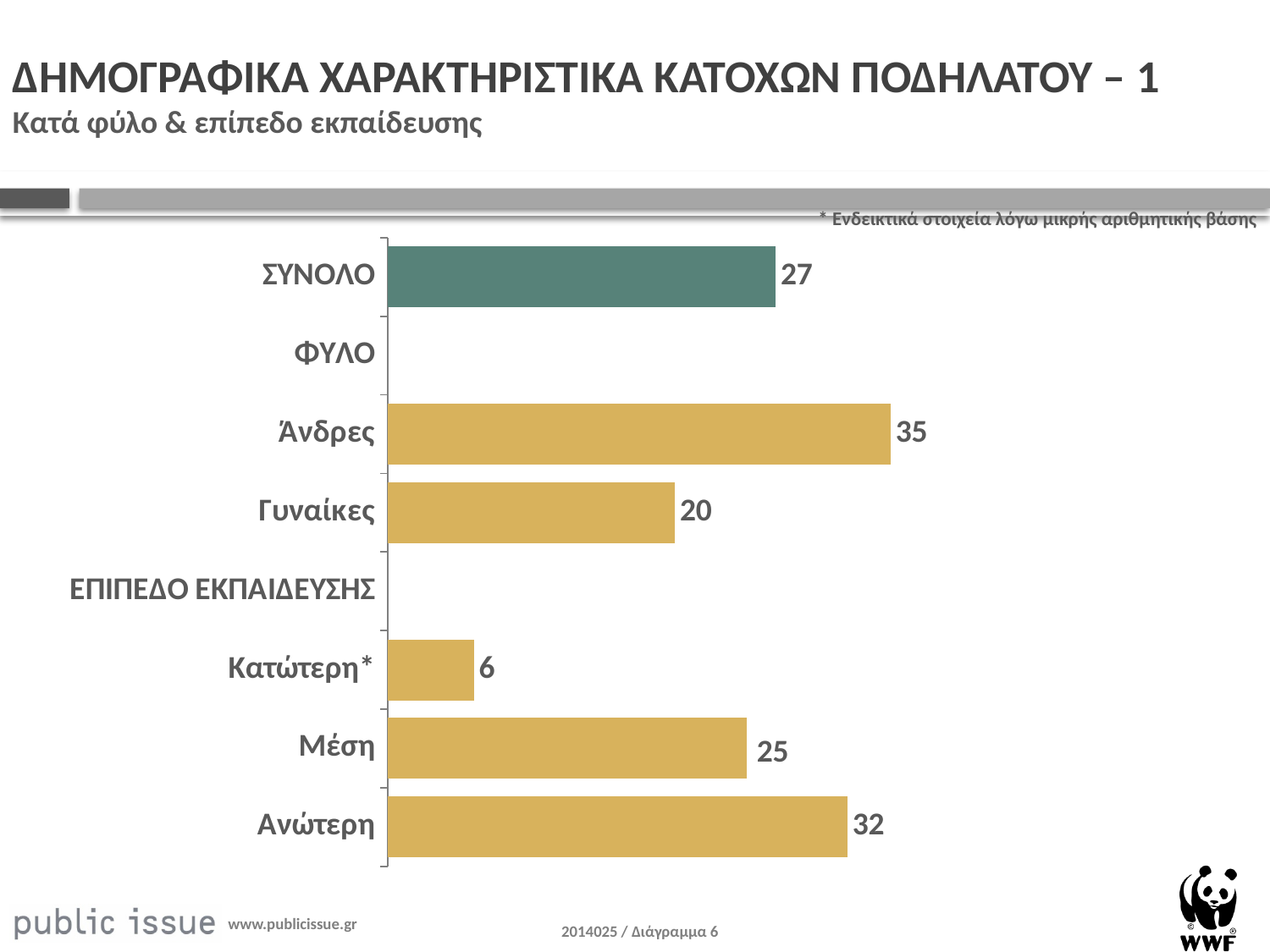
Which is larger, the value for Μέση or the value for Ανώτερη? Ανώτερη What is the subtitle of the chart? Κατά φύλο & επίπεδο εκπαίδευσης What is the value for Ανώτερη? 32 What kind of chart is shown on the slide? bar chart What is the value for Άνδρες? 35 What is the difference between the values for Άνδρες and Γυναίκες? 15 What is the value for Κατώτερη*? 6 What is the value for Γυναίκες? 20 What is the value for ΣΥΝΟΛΟ? 27 Which category has the lowest value? Κατώτερη* How many bars with values are plotted in the chart? 6 Which category has the highest value? Άνδρες